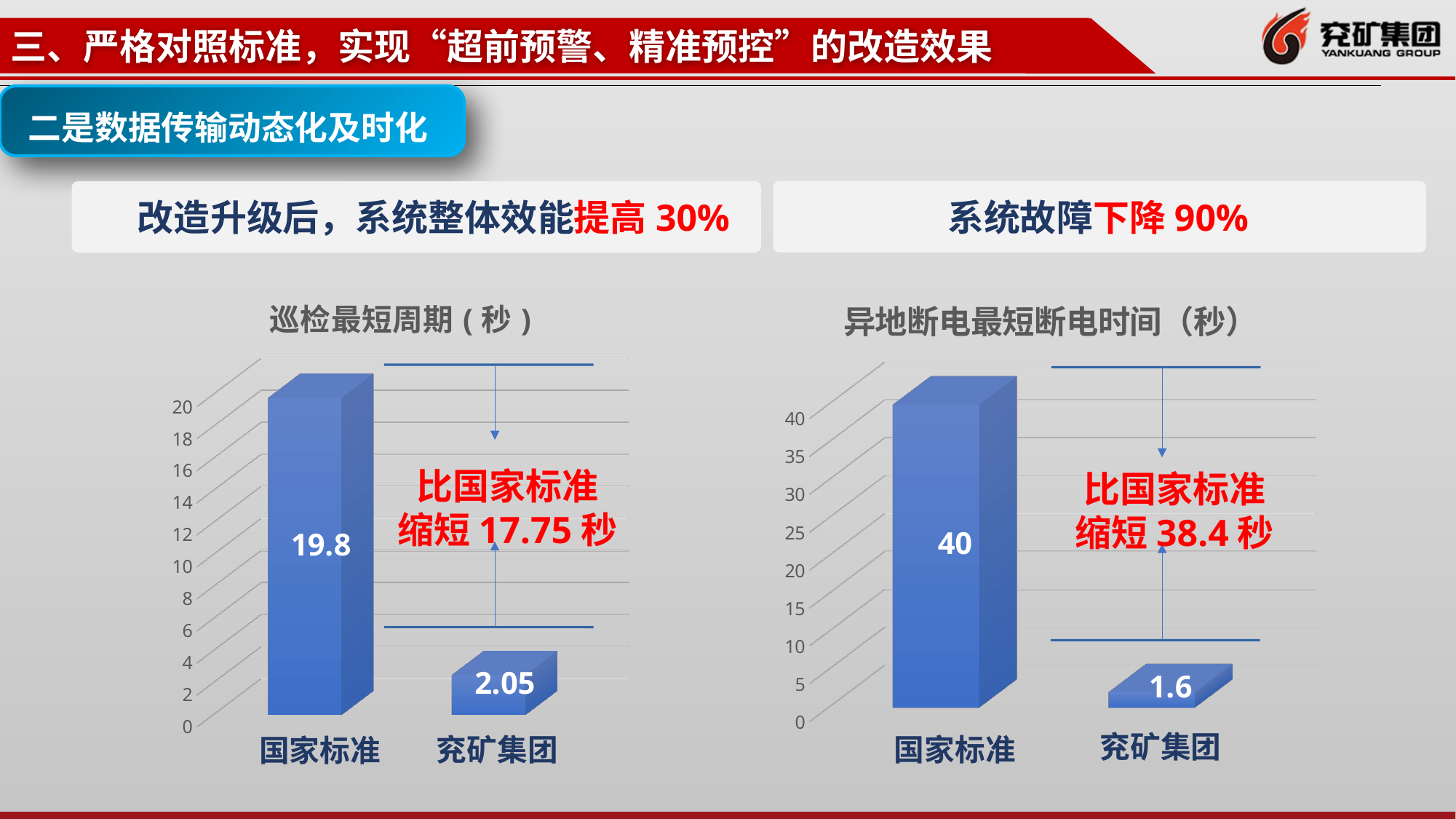
In the chart titled 巡检最短周期（秒）, what is the difference between the values for 国家标准 and 兖矿集团? 17.75 In the chart titled 异地断电最短断电时间（秒）, what is the value for 兖矿集团? 1.6 What kind of chart is the chart titled 巡检最短周期（秒）? bar chart In the chart titled 巡检最短周期（秒）, which category has the lowest value? 兖矿集团 How many categories are shown in the chart titled 异地断电最短断电时间（秒）? 2 In the chart titled 巡检最短周期（秒）, what is the value for 国家标准? 19.8 In the chart titled 巡检最短周期（秒）, is the value for 兖矿集团 greater or less than 4? less In the chart titled 异地断电最短断电时间（秒）, what is the value for 国家标准? 40 In the chart titled 异地断电最短断电时间（秒）, what is the difference between the values for 国家标准 and 兖矿集团? 38.4 In the chart titled 巡检最短周期（秒）, what is the value for 兖矿集团? 2.05 In the chart titled 异地断电最短断电时间（秒）, which is larger, the value for 国家标准 or 兖矿集团? 国家标准 In the chart titled 异地断电最短断电时间（秒）, which category has the highest value? 国家标准